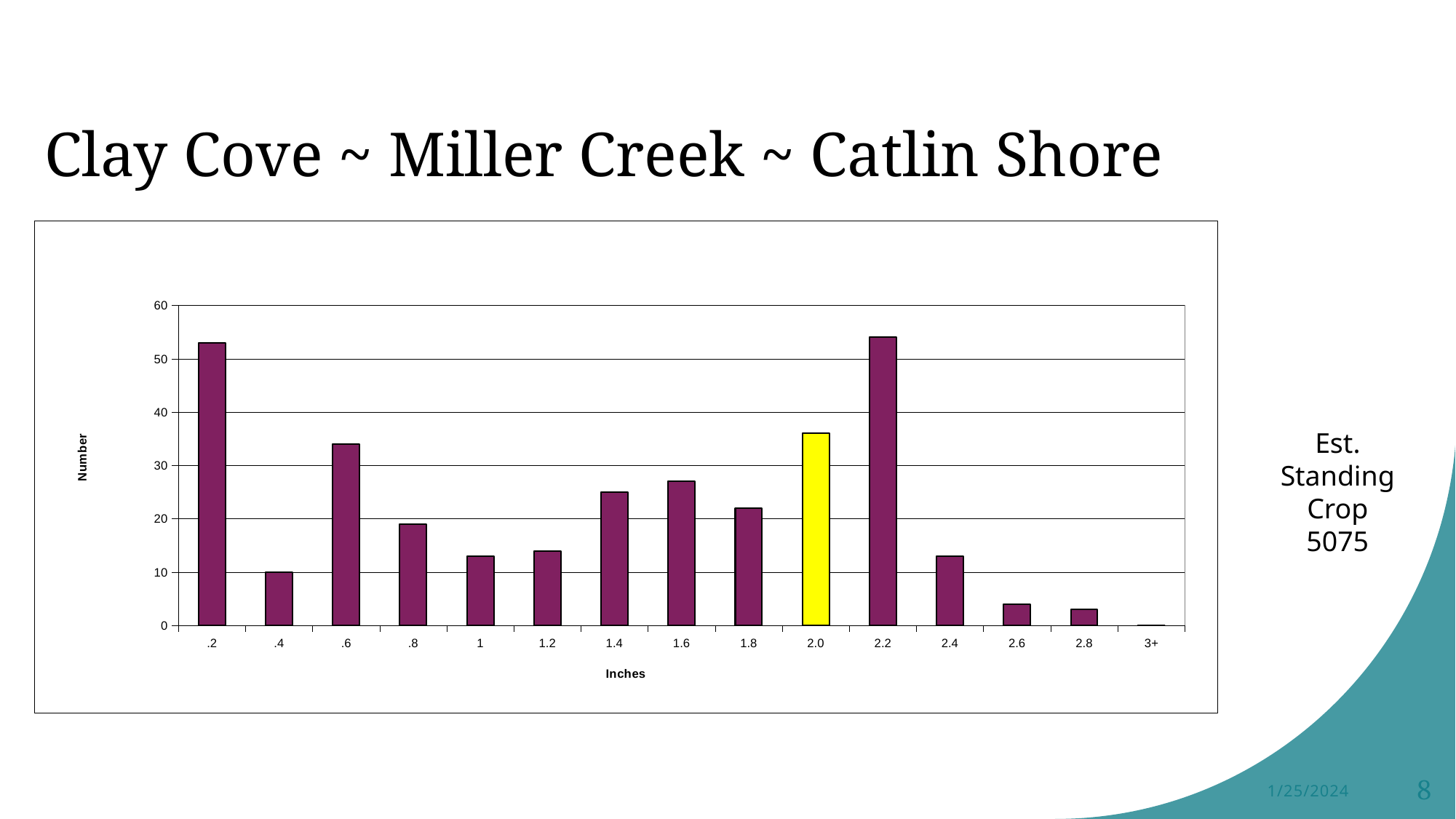
What is the label of the x axis of the chart? Inches Which has the larger value, .6 or .8? .6 Is the value for 2.0 greater or less than 30? greater Is the value for 2.0 greater or less than 40? less How many categories are shown along the x axis of the chart? 15 Which category's bar is coloured yellow instead of purple? 2.0 What kind of chart is shown on the slide? bar chart Is the value for 2.6 greater or less than 10? less Which has the larger value, 1.6 or 1.8? 1.6 Which category has the lowest value in the chart? 3+